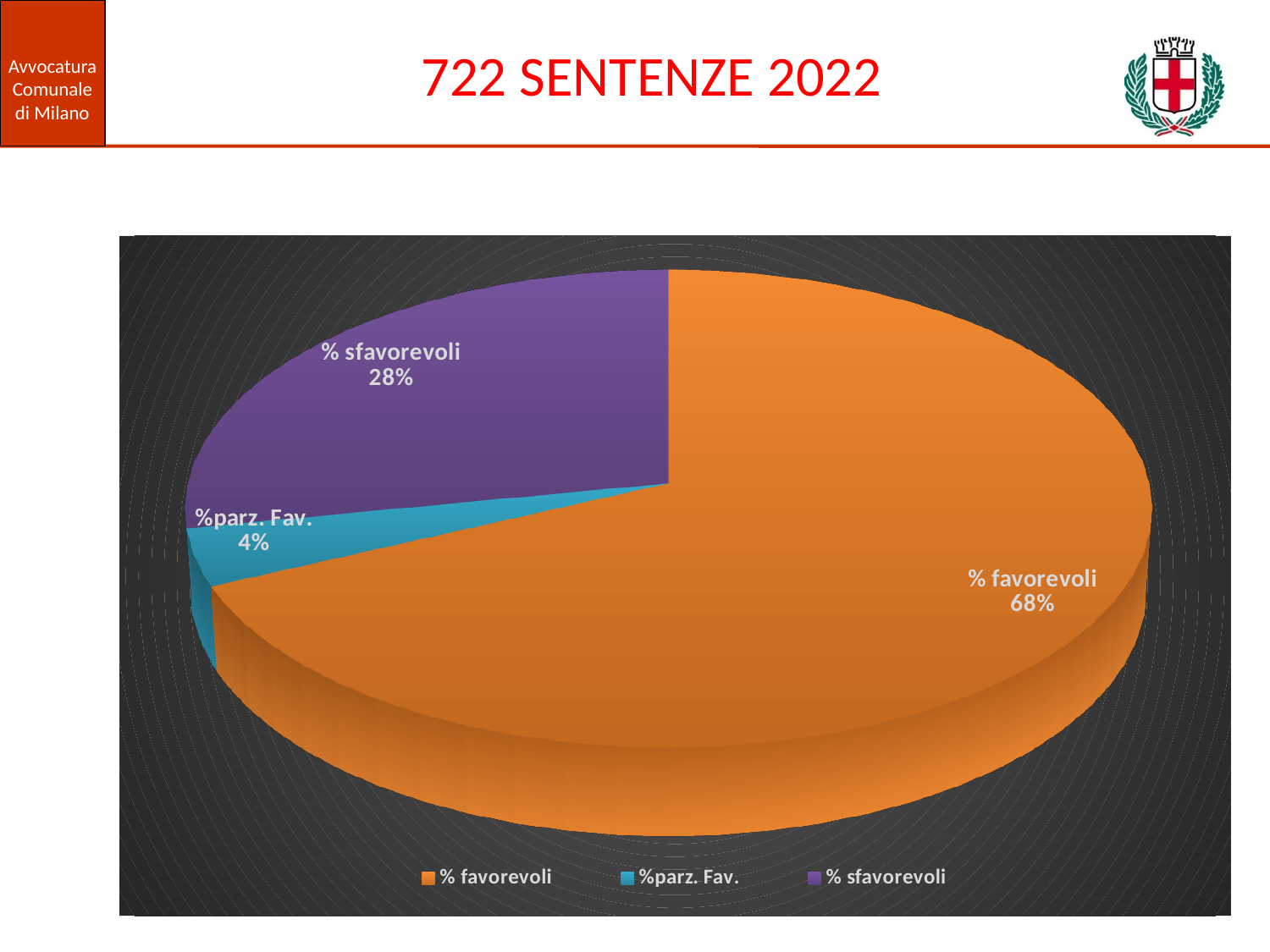
What colour is the "% sfavorevoli" slice? Purple Which slice of the pie is the largest? % favorevoli What percentage of the pie is labelled "% favorevoli"? 68% Which slice of the pie is the smallest? %parz. Fav. What percentage of the pie is labelled "%parz. Fav."? 4% What percentage of the pie is labelled "% sfavorevoli"? 28% What is the difference in percentage points between the "% favorevoli" and "% sfavorevoli" slices? 40 What is the title of the slide containing the chart? 722 SENTENZE 2022 How many entries does the legend list? 3 What kind of chart is shown on the slide? Pie chart How many slices does the pie chart have? 3 Which is larger, the "% sfavorevoli" slice or the "%parz. Fav." slice? % sfavorevoli